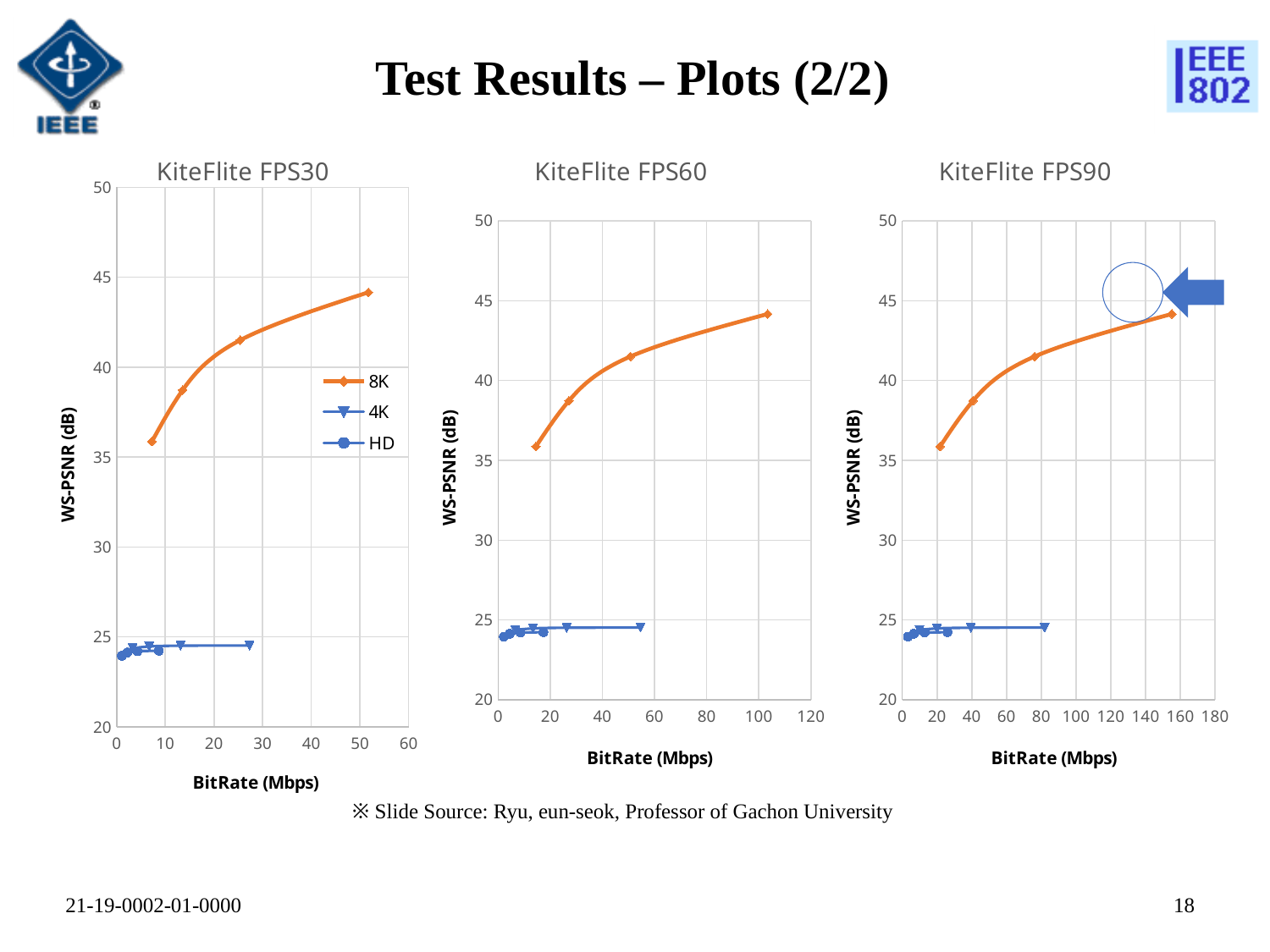
In the KiteFlite FPS30 chart, is the lowest WS-PSNR value of the 8K series greater or less than 30? greater In the KiteFlite FPS30 chart, is the highest WS-PSNR value of the 8K series greater or less than 40? greater In the KiteFlite FPS90 chart, are the WS-PSNR values of the 4K series greater or less than 30? less What is the x-axis label on the KiteFlite FPS60 chart? BitRate (Mbps) In the KiteFlite FPS60 chart, does the 8K series rise or fall as bitrate increases? rise Across the three charts, in which chart does the 8K series reach the highest bitrate? KiteFlite FPS90 How many data points are plotted on the 8K series in the KiteFlite FPS90 chart? 4 How many series does the legend on the KiteFlite FPS30 chart list? 3 What kind of chart is the KiteFlite FPS30 chart? line chart In the KiteFlite FPS60 chart, which series reaches higher WS-PSNR values, 8K or 4K? 8K What are the legend entries on the KiteFlite FPS30 chart? 8K, 4K, HD